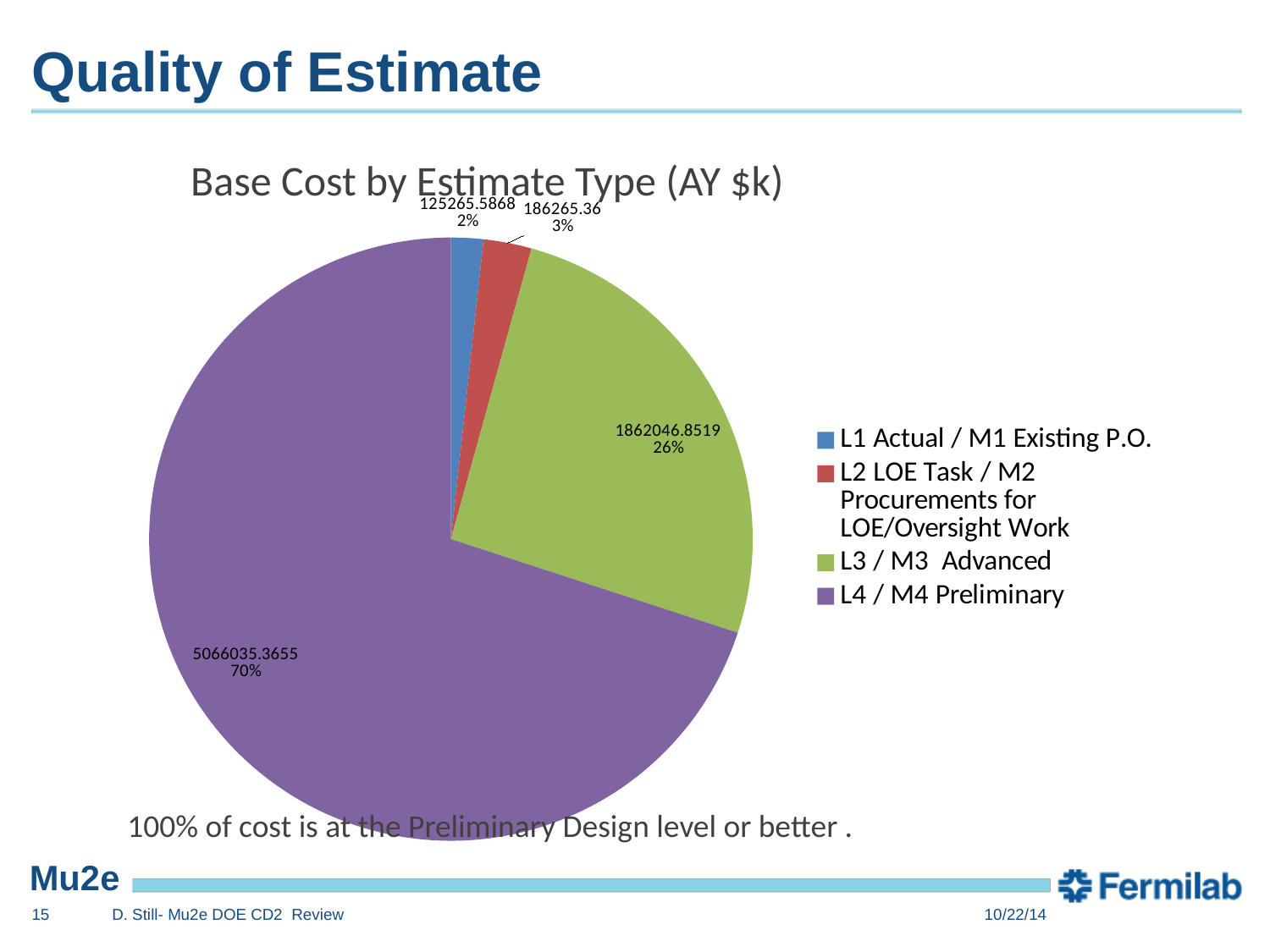
What is the value shown for L3 / M3 Advanced? 1862046.8519 What is the value shown for L4 / M4 Preliminary? 5066035.3655 How many slices does the pie chart have? 4 What type of chart is shown on the slide? pie chart How many entries does the legend list? 4 What share of the pie does L3 / M3 Advanced represent? 26% Which category has the smallest slice of the pie? L1 Actual / M1 Existing P.O. What is the value shown for L1 Actual / M1 Existing P.O.? 125265.5868 What share of the pie does L4 / M4 Preliminary represent? 70% What is the title of the chart? Base Cost by Estimate Type (AY $k) Which category has the largest slice of the pie? L4 / M4 Preliminary What is the difference between the values for L4 / M4 Preliminary and L3 / M3 Advanced? 3203988.5136